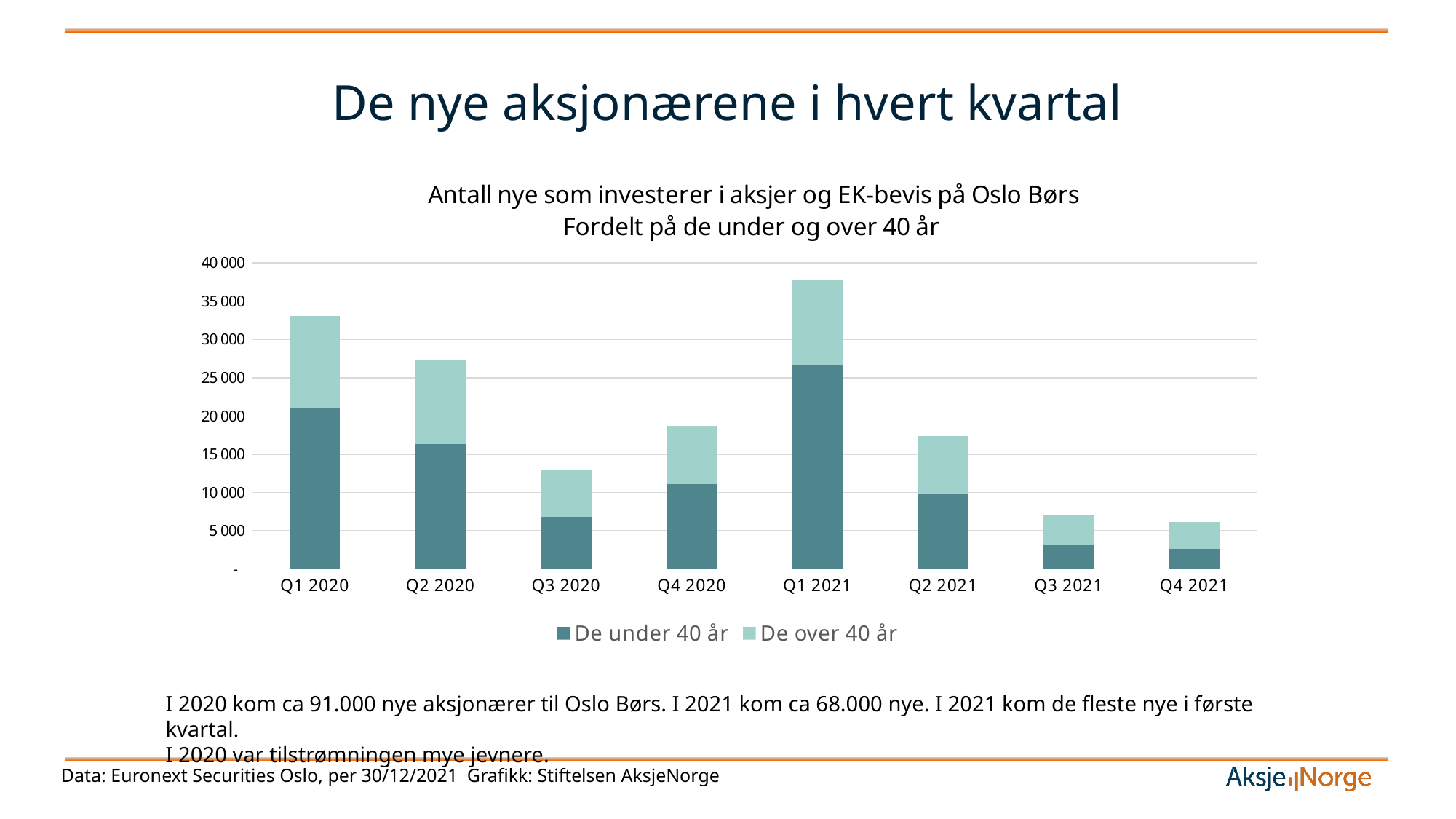
What are the two series named in the chart's legend? De under 40 år and De over 40 år Which quarter has the lowest total number of new shareholders? Q4 2021 Which quarter has the highest total number of new shareholders? Q1 2021 Is the 'De under 40 år' value for Q2 2020 greater or less than 15 000? greater What kind of chart is shown on the slide? Stacked bar chart Is the total value for Q3 2020 greater or less than 15 000? less Do the total values rise or fall from Q1 2021 to Q4 2021? fall How many quarters are shown on the x axis of the chart? 8 How many series does the chart's legend list? 2 Is the 'De under 40 år' value for Q1 2021 greater or less than 25 000? greater Which quarter has a larger total, Q1 2020 or Q2 2020? Q1 2020